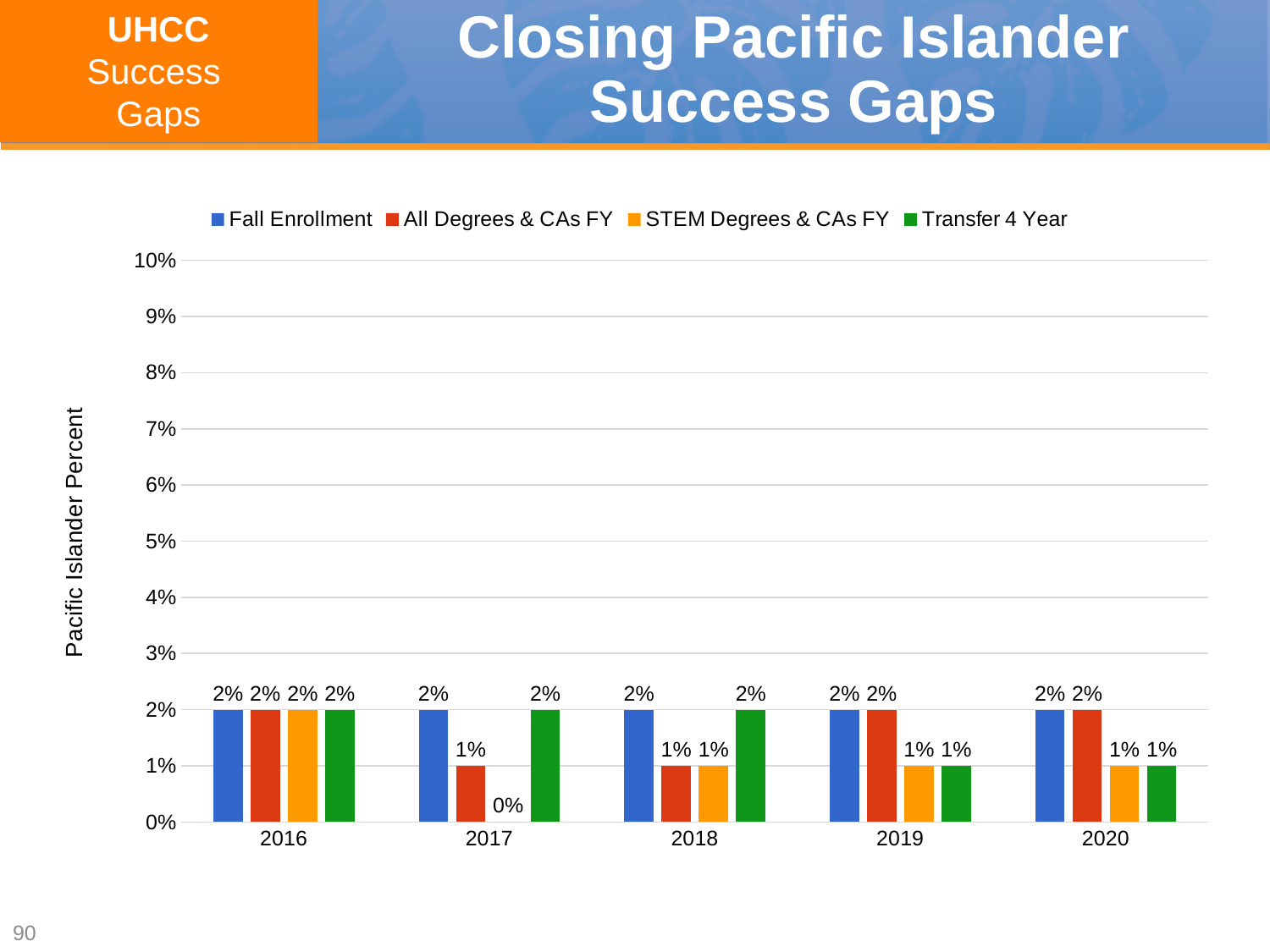
What is the value for All Degrees & CAs FY in 2018? 1% Which is larger in 2017, All Degrees & CAs FY or Transfer 4 Year? Transfer 4 Year In which year is the STEM Degrees & CAs FY value lowest? 2017 What is the value for STEM Degrees & CAs FY in 2017? 0% What is the label on the vertical axis? Pacific Islander Percent What is the difference between Fall Enrollment and STEM Degrees & CAs FY in 2019? 1% Is the value for Fall Enrollment in 2016 greater or less than 3%? less How many years are shown on the x axis? 5 What is the value for Transfer 4 Year in 2020? 1% What kind of chart is shown on the slide? bar chart What is the value for Fall Enrollment in 2019? 2% How many series does the legend list? 4